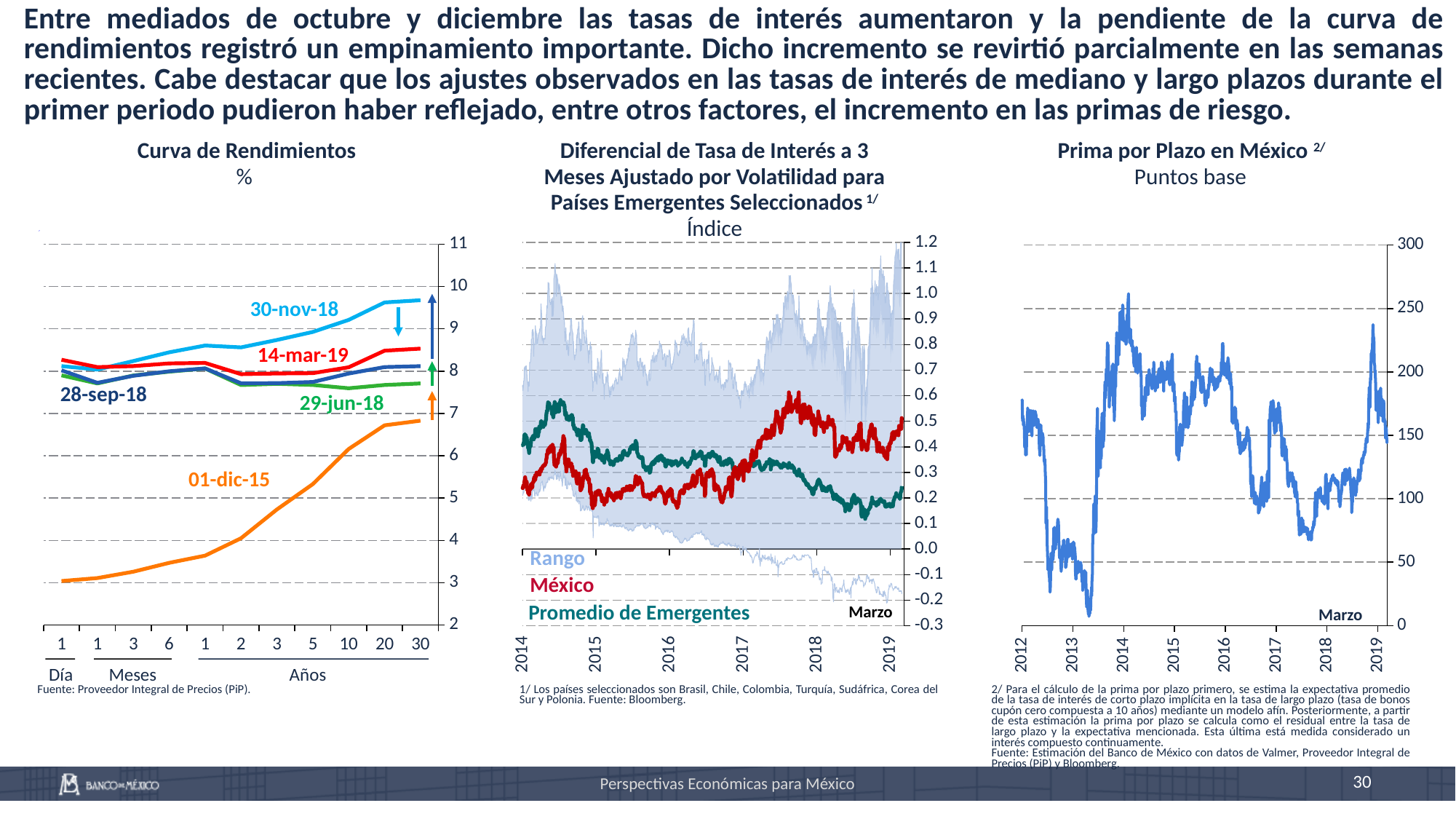
In the 'Curva de Rendimientos' chart, what unit is shown under the title? % In the 'Curva de Rendimientos' chart, how many dated yield curves are labelled? 5 In the 'Curva de Rendimientos' chart, which curve is the highest at the 30-year point? 30-nov-18 In the 'Diferencial de Tasa de Interés a 3 Meses' chart, how many series does the legend list? 3 In the 'Prima por Plazo en México' chart, is the lowest value reached in 2013 greater or less than 50? less In the 'Curva de Rendimientos' chart, which curve is the lowest across the whole x axis? 01-dic-15 In the 'Diferencial de Tasa de Interés a 3 Meses' chart, at the end of the series (Marzo 2019), which is higher: México or Promedio de Emergentes? México In the 'Curva de Rendimientos' chart, does the 01-dic-15 curve rise or fall as maturity increases along the x axis? rises In the 'Diferencial de Tasa de Interés a 3 Meses' chart, is the Promedio de Emergentes value at the end of the series greater or less than 0.3? less In the 'Curva de Rendimientos' chart, at 30 years, which is higher: the 30-nov-18 curve or the 14-mar-19 curve? 30-nov-18 What kind of chart is the 'Curva de Rendimientos' chart? line chart In the 'Curva de Rendimientos' chart, is the 01-dic-15 value at 1 day greater or less than 4? less